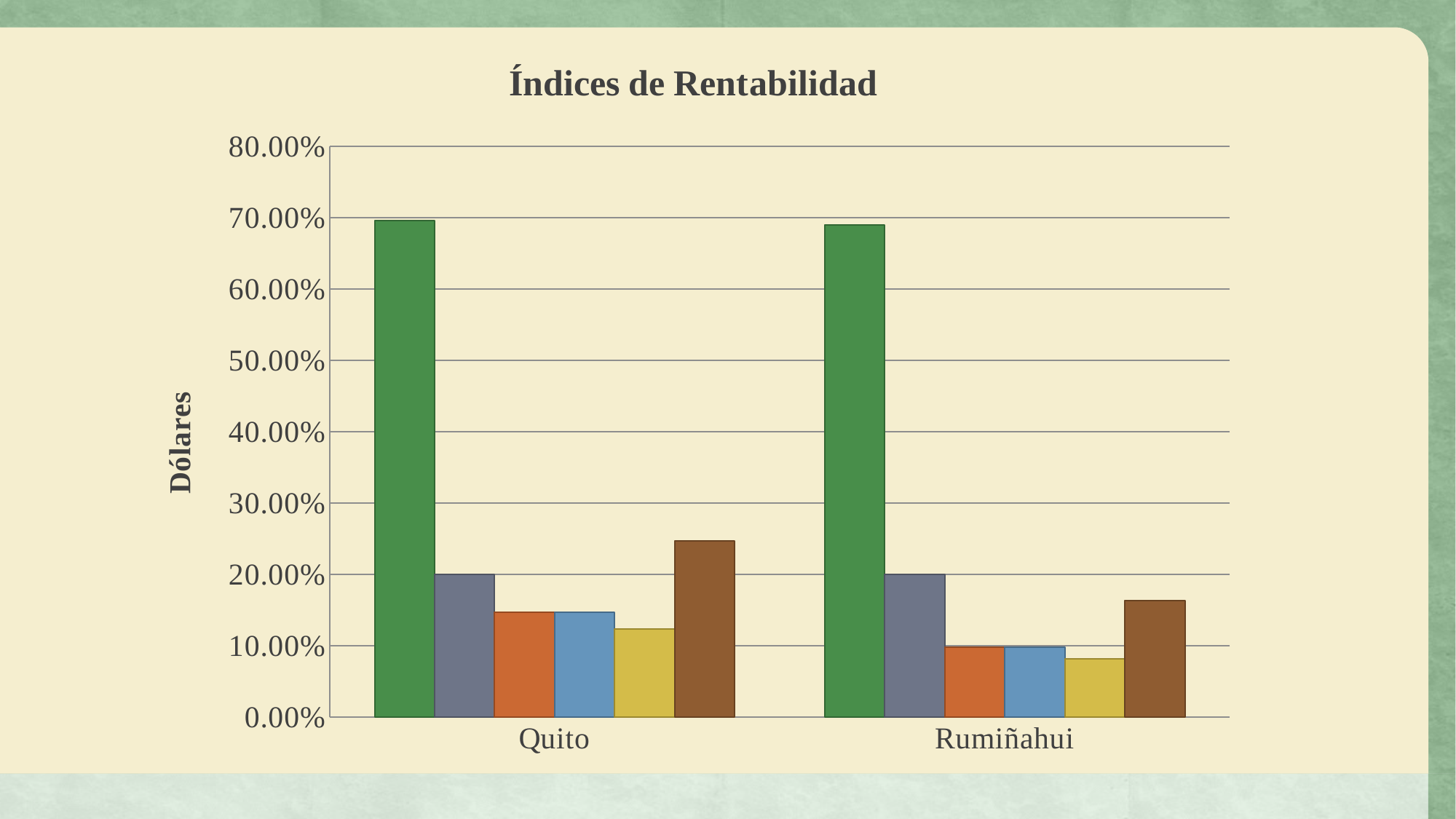
What kind of chart is shown on the slide? bar chart Is the value of the green bar for Quito greater or less than 60.00%? greater How many bars are plotted for the Quito category? 6 Within the Quito category, which coloured bar is the tallest? green Which category has the larger brown bar, Quito or Rumiñahui? Quito How many categories are shown on the x axis of the chart? 2 What is the label on the vertical axis of the chart? Dólares What is the title of the chart? Índices de Rentabilidad Is the value of the brown bar for Quito greater or less than 20.00%? greater Is the value of the brown bar for Rumiñahui greater or less than 20.00%? less